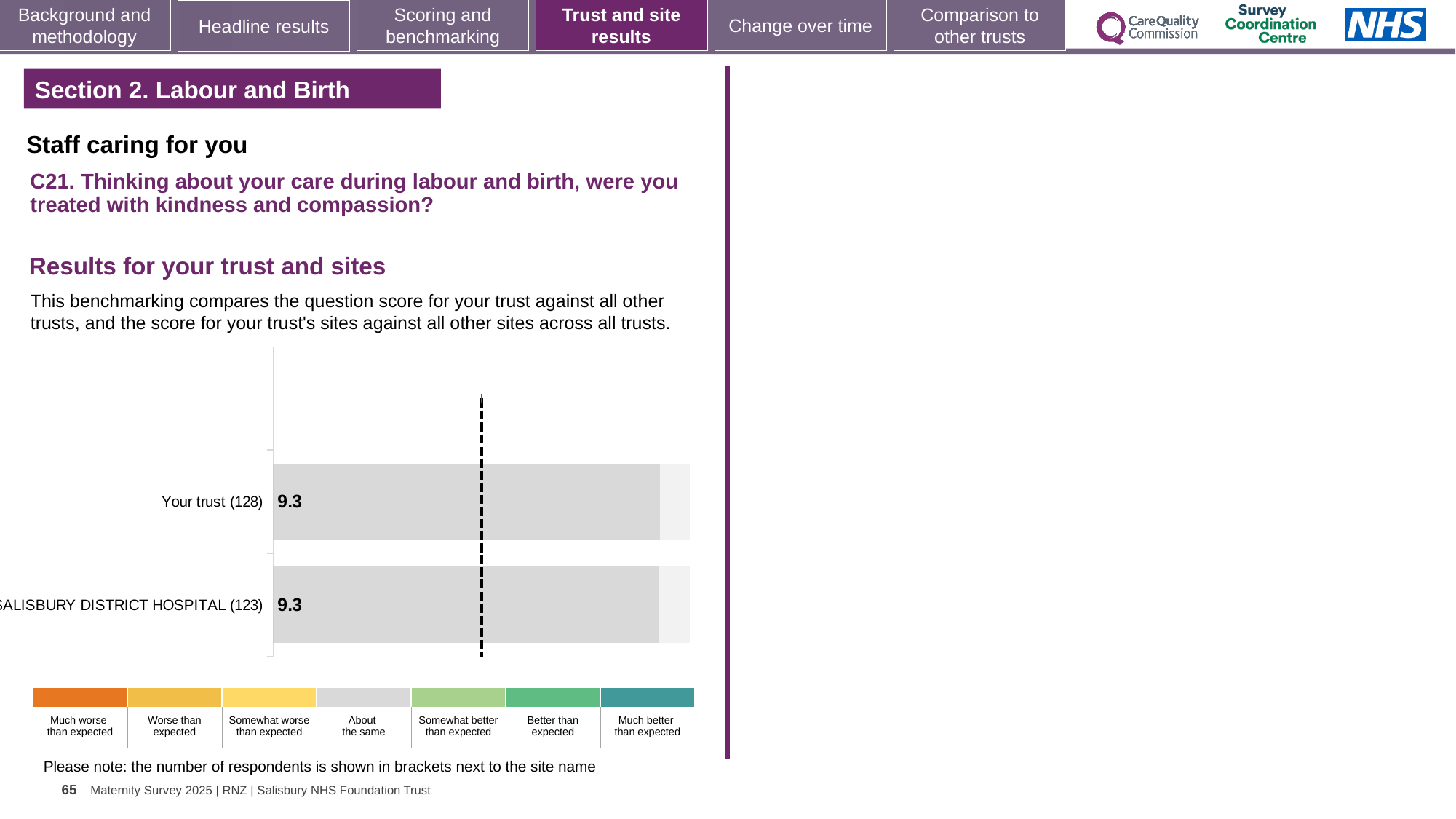
What is the difference between the score for Your trust and the score for SALISBURY DISTRICT HOSPITAL? 0 Which benchmark category does the grey colour of the bars correspond to in the legend? About the same How many benchmark categories are listed in the colour legend below the chart? 7 How many bars are plotted in the chart? 2 How many respondents are shown in brackets for SALISBURY DISTRICT HOSPITAL? 123 How many respondents are shown in brackets for Your trust? 128 What kind of chart is shown on the slide? Bar chart What is the score for Your trust? 9.3 What is the score for SALISBURY DISTRICT HOSPITAL? 9.3